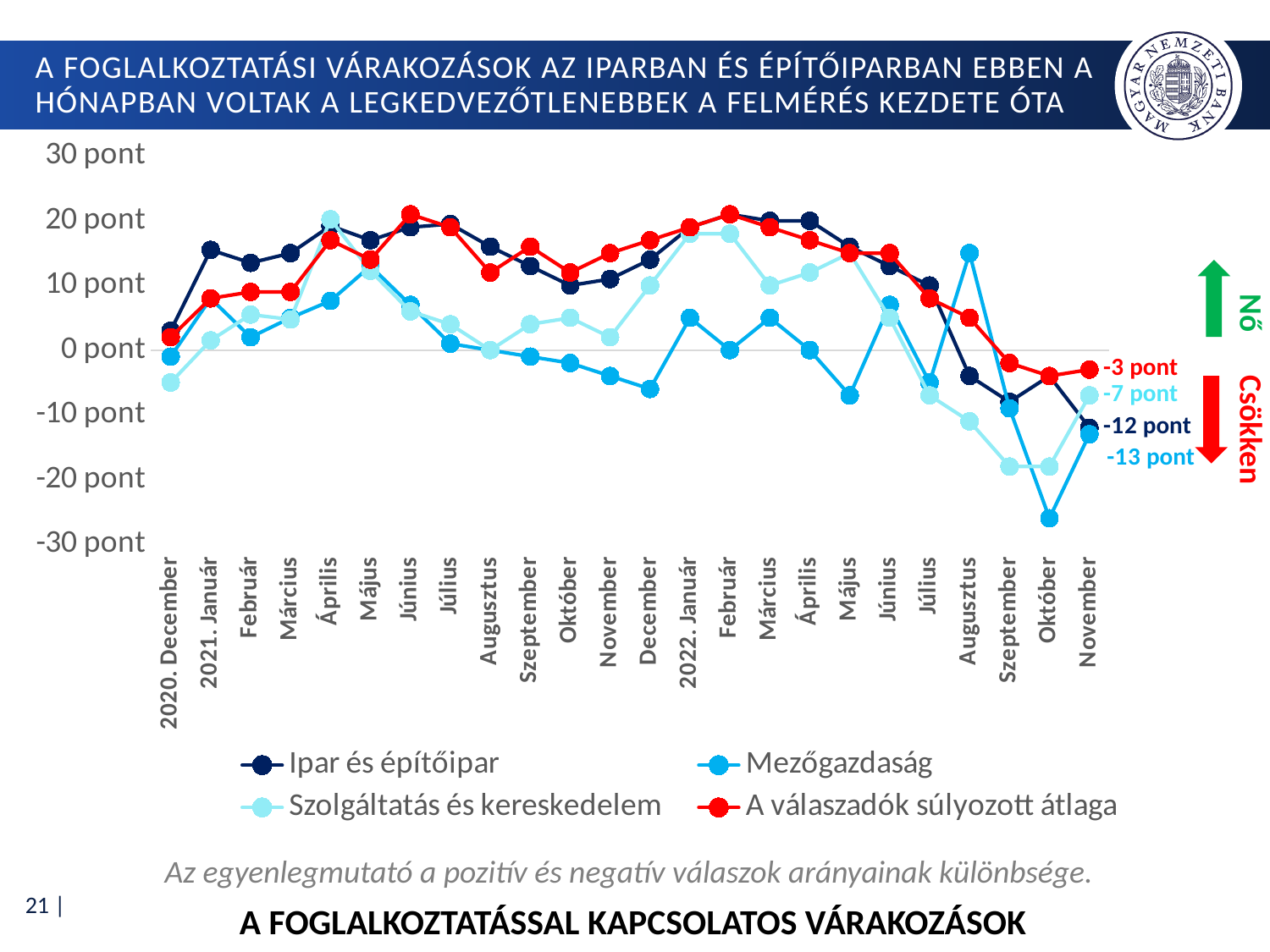
What kind of chart is shown on the slide? Line chart Which series has the lowest value in November 2022? Mezőgazdaság What is the value of the Szolgáltatás és kereskedelem series in November 2022? -7 pont What is the value of the Mezőgazdaság series in November 2022? -13 pont How many months are shown on the x axis? 24 What is the value of A válaszadók súlyozott átlaga in November 2022? -3 pont Is the value for Ipar és építőipar in 2021 Január greater or less than 10 pont? greater What is the difference between A válaszadók súlyozott átlaga and Mezőgazdaság in November 2022? 10 pont How many series does the legend list? 4 Is the value for Mezőgazdaság in October 2022 greater or less than -20 pont? less What is the value of the Ipar és építőipar series in November 2022? -12 pont In November 2022, which is higher: Ipar és építőipar or Szolgáltatás és kereskedelem? Szolgáltatás és kereskedelem